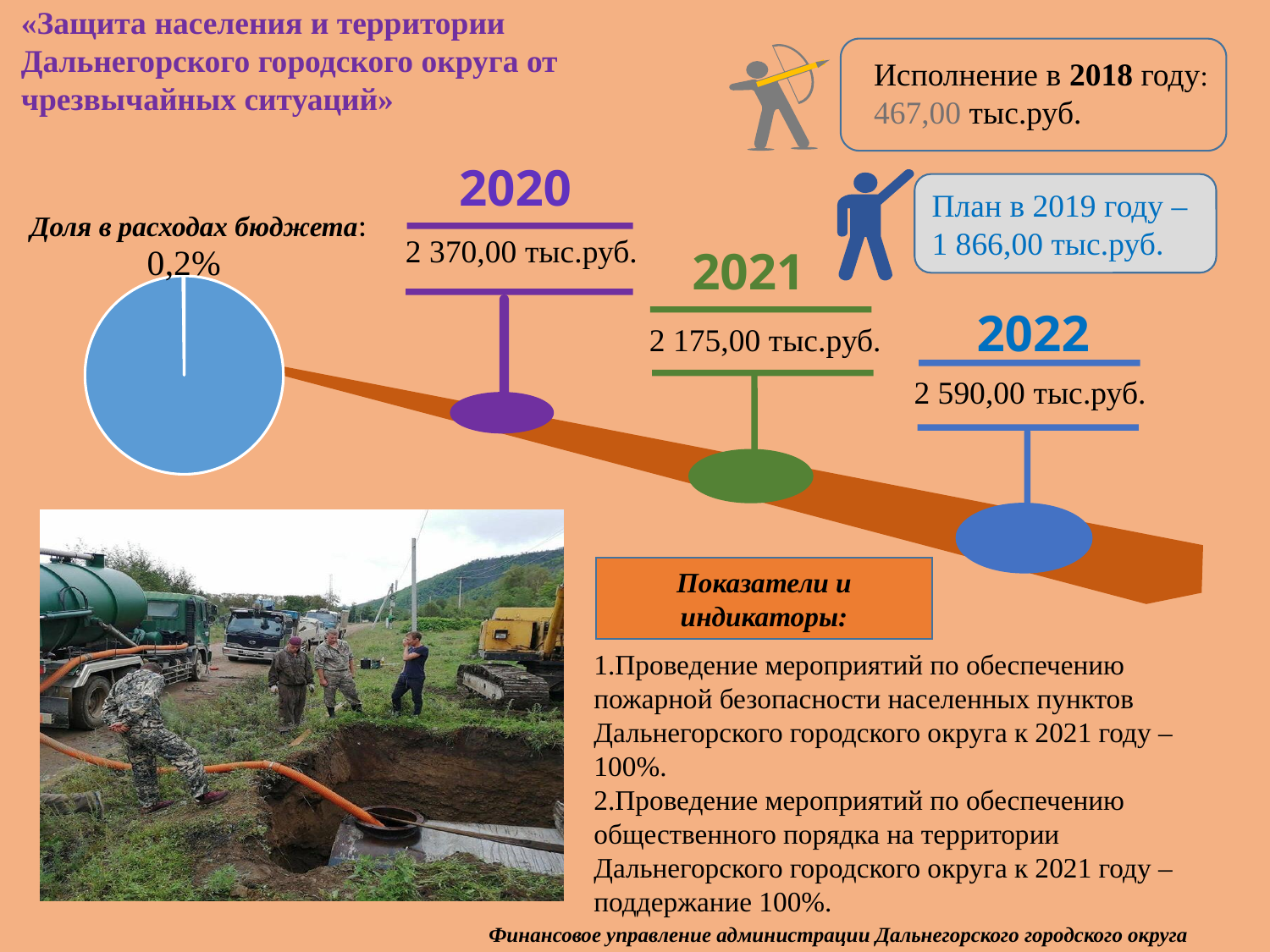
What kind of chart is shown under the heading «Доля в расходах бюджета»? pie chart What colour is the large slice of the pie chart? blue What share of budget expenditure does the pie chart label show? 0,2% What is the title written next to the pie chart? Доля в расходах бюджета What is the value printed above the pie chart? 0,2% Is the share shown on the pie chart greater or less than 1%? less